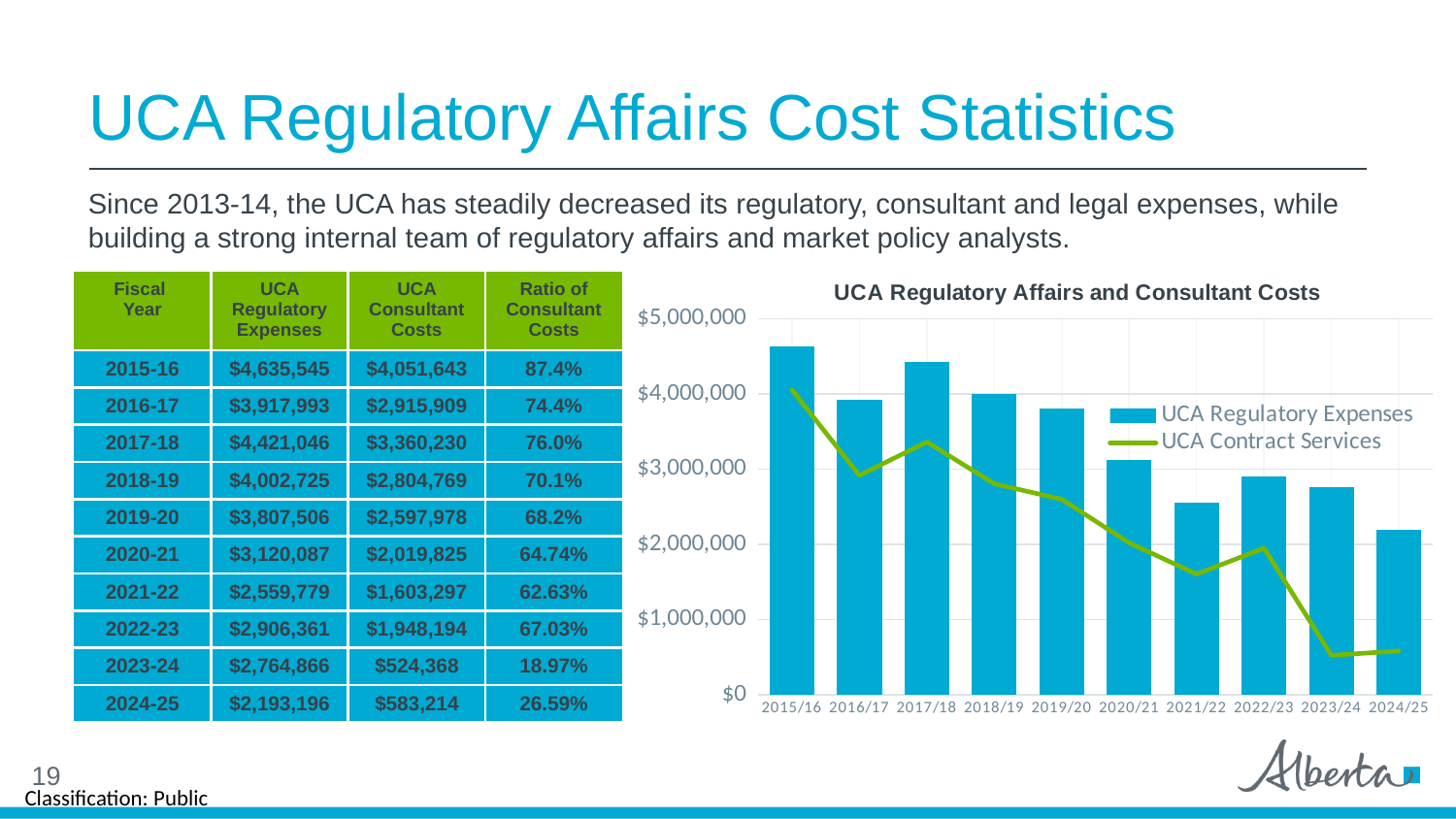
Which fiscal year has the lowest UCA Regulatory Expenses bar? 2024/25 Is the UCA Contract Services value for 2023/24 greater or less than $1,000,000? less Is the UCA Regulatory Expenses value for 2024/25 greater or less than $2,000,000? greater Do the UCA Contract Services values generally rise or fall from 2015/16 to 2024/25? fall What is the difference between UCA Regulatory Expenses in 2015-16 and 2024-25? $2,442,349 What is the title of the chart? UCA Regulatory Affairs and Consultant Costs How many series does the chart legend list? 2 What is the UCA Regulatory Expenses value for 2015-16? $4,635,545 How many fiscal years are plotted along the x axis of the chart? 10 Which is larger, the UCA Regulatory Expenses bar for 2021/22 or for 2022/23? 2022/23 What kind of chart is shown on the slide? A bar chart with a line series Which fiscal year has the highest UCA Regulatory Expenses bar? 2015/16